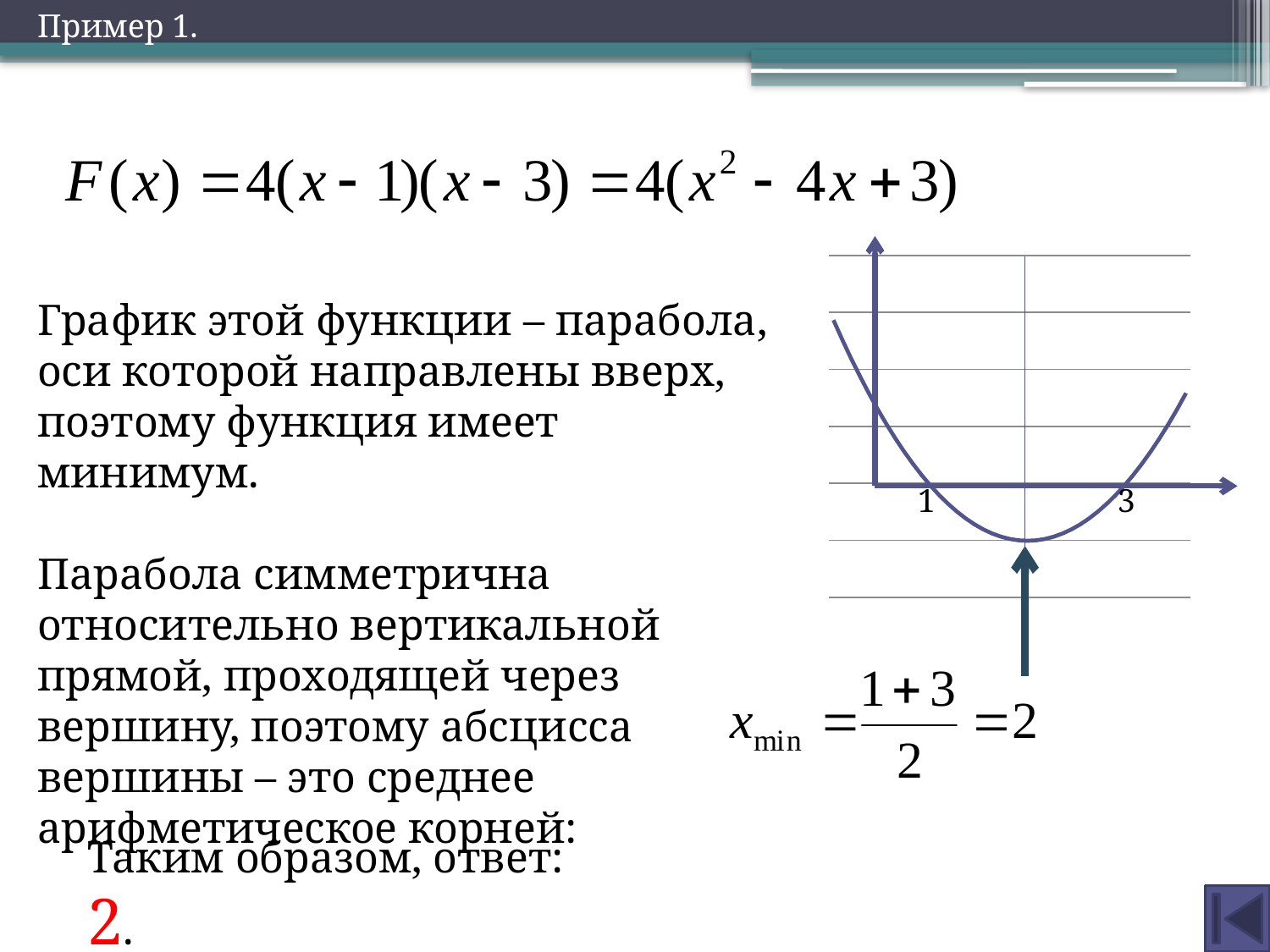
Which of the two labelled x-axis values is larger, 1 or 3? 3 Moving from x = 2 to x = 3, does the curve rise or fall? rise What does the vertical arrow below the graph point to? the vertex (minimum) of the parabola Is the value of the function at x = 2 greater or less than 0? less What is the difference between the two labelled roots on the x axis? 2 What is the x coordinate of the minimum of the parabola, as given on the slide? 2 Between x = 1 and x = 3, is the parabola above or below the x axis? below Moving from x = 1 to x = 2, does the curve rise or fall? fall How many x-axis tick labels are printed on the graph? 2 Does the parabola open upward or downward? upward At which two x values does the parabola cross the x axis? 1 and 3 What kind of graph is drawn on the slide? a line graph (parabola)